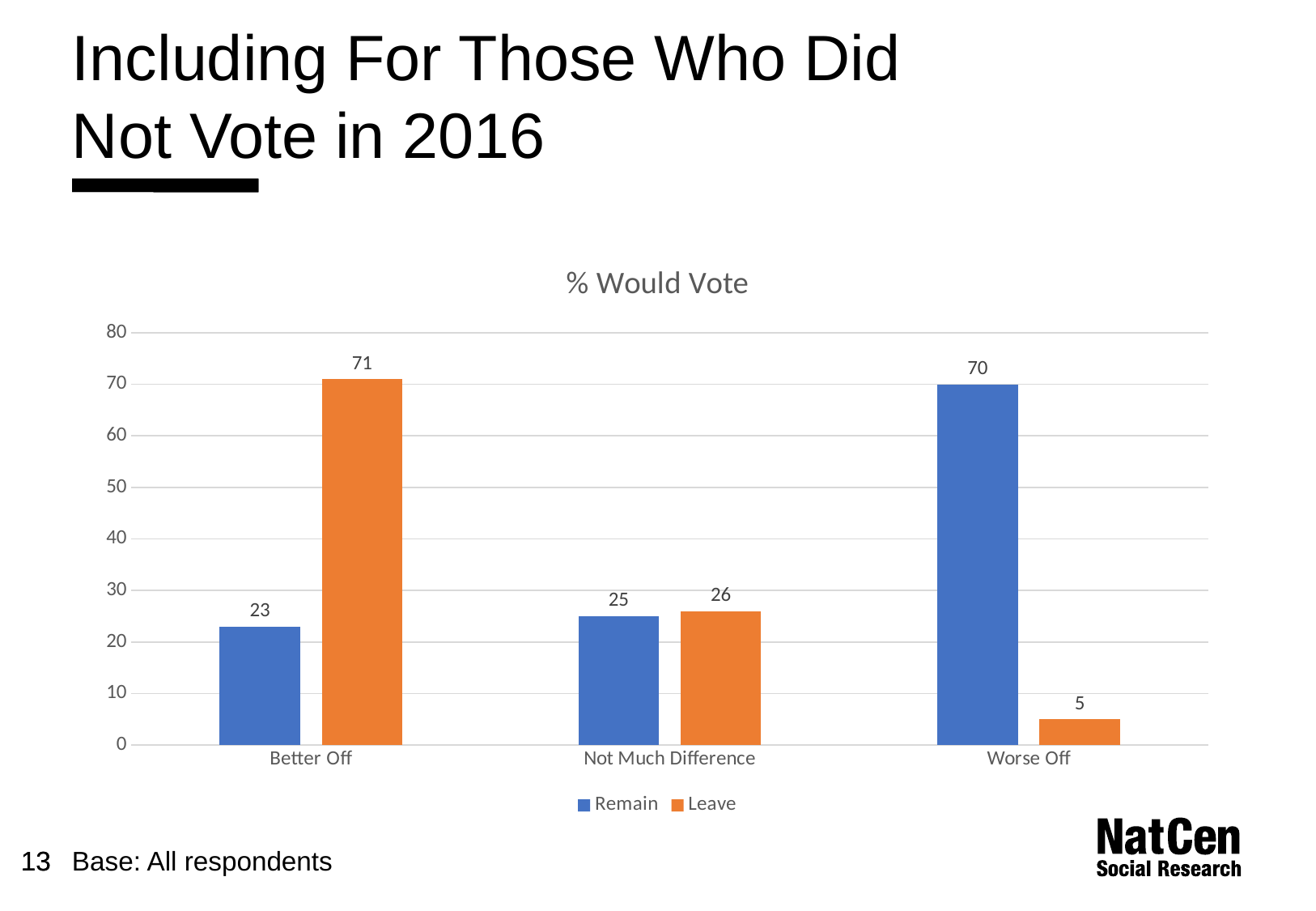
What is the Leave value for Worse Off? 5 What kind of chart is shown on the slide? Bar chart Which colour represents the Leave series? Orange How many series does the legend list? 2 How many categories are shown on the x axis? 3 Which category has the highest Remain value? Worse Off What is the difference between the Leave and Remain values for Better Off? 48 What is the title of the chart? % Would Vote What is the Remain value for Better Off? 23 Which category has the lowest Leave value? Worse Off What is the Leave value for Not Much Difference? 26 Which is larger for Worse Off, Remain or Leave? Remain